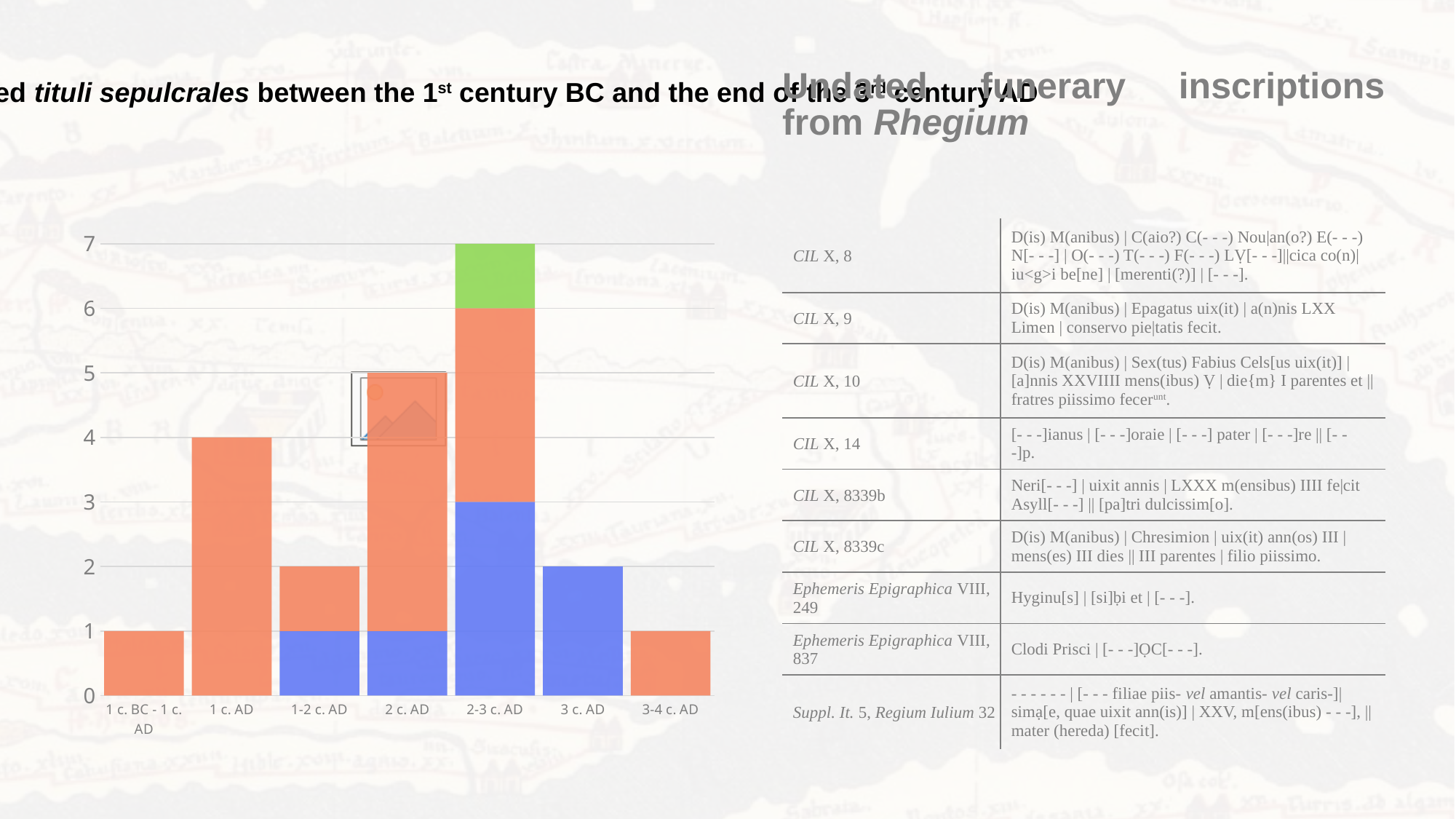
How many categories are shown on the x axis of the chart? 7 What is the total height of the bar for 3 c. AD? 2 What is the total height of the bar for 1 c. AD? 4 What is the value of the orange segment for 1 c. BC - 1 c. AD? 1 Which bar is taller, 1 c. AD or 2 c. AD? 2 c. AD What type of chart is shown on the slide? stacked bar chart What is the total height of the bar for 2-3 c. AD? 7 Which category has the tallest bar in the chart? 2-3 c. AD Which category is the only one with a green segment? 2-3 c. AD What is the difference between the total bar heights for 2-3 c. AD and 3-4 c. AD? 6 What is the value of the blue segment for 2-3 c. AD? 3